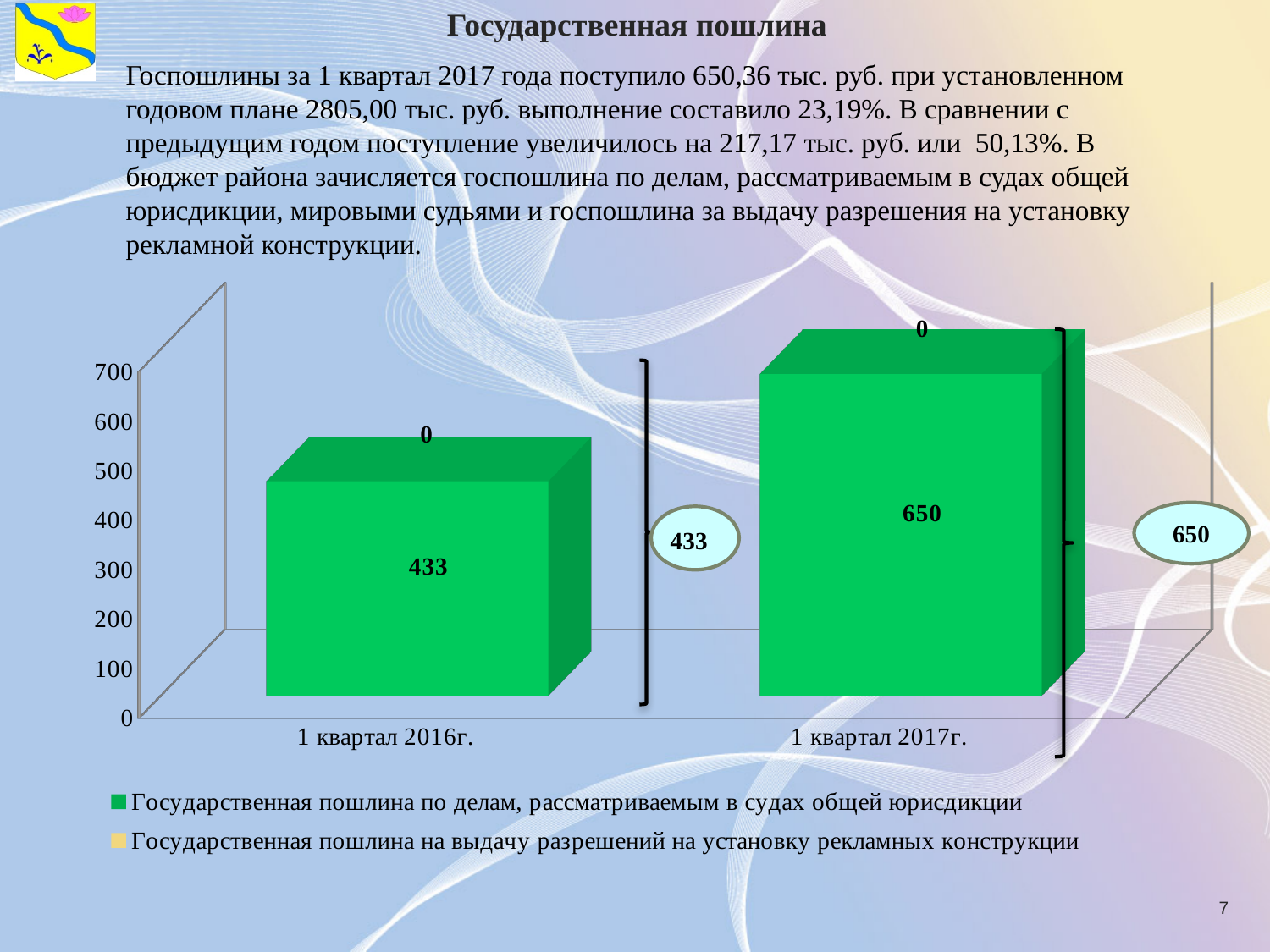
What is the value of the series Государственная пошлина на выдачу разрешений на установку рекламных конструкции for 1 квартал 2017г.? 0 What is the difference between the green series values for 1 квартал 2017г. and 1 квартал 2016г.? 217 What is the total of the stacked bar for 1 квартал 2017г.? 650 What is the value of the green series (Государственная пошлина по делам, рассматриваемым в судах общей юрисдикции) for 1 квартал 2017г.? 650 Is the value for 1 квартал 2016г. greater or less than 500? less Which category has the higher value for the green series? 1 квартал 2017г. What is the value of the green series (Государственная пошлина по делам, рассматриваемым в судах общей юрисдикции) for 1 квартал 2016г.? 433 Is the green series value for 1 квартал 2017г. larger or smaller than for 1 квартал 2016г.? larger Which category has the lower value for the green series? 1 квартал 2016г. How many categories are shown on the x axis? 2 How many series does the legend list? 2 What kind of chart is shown on the slide? bar chart